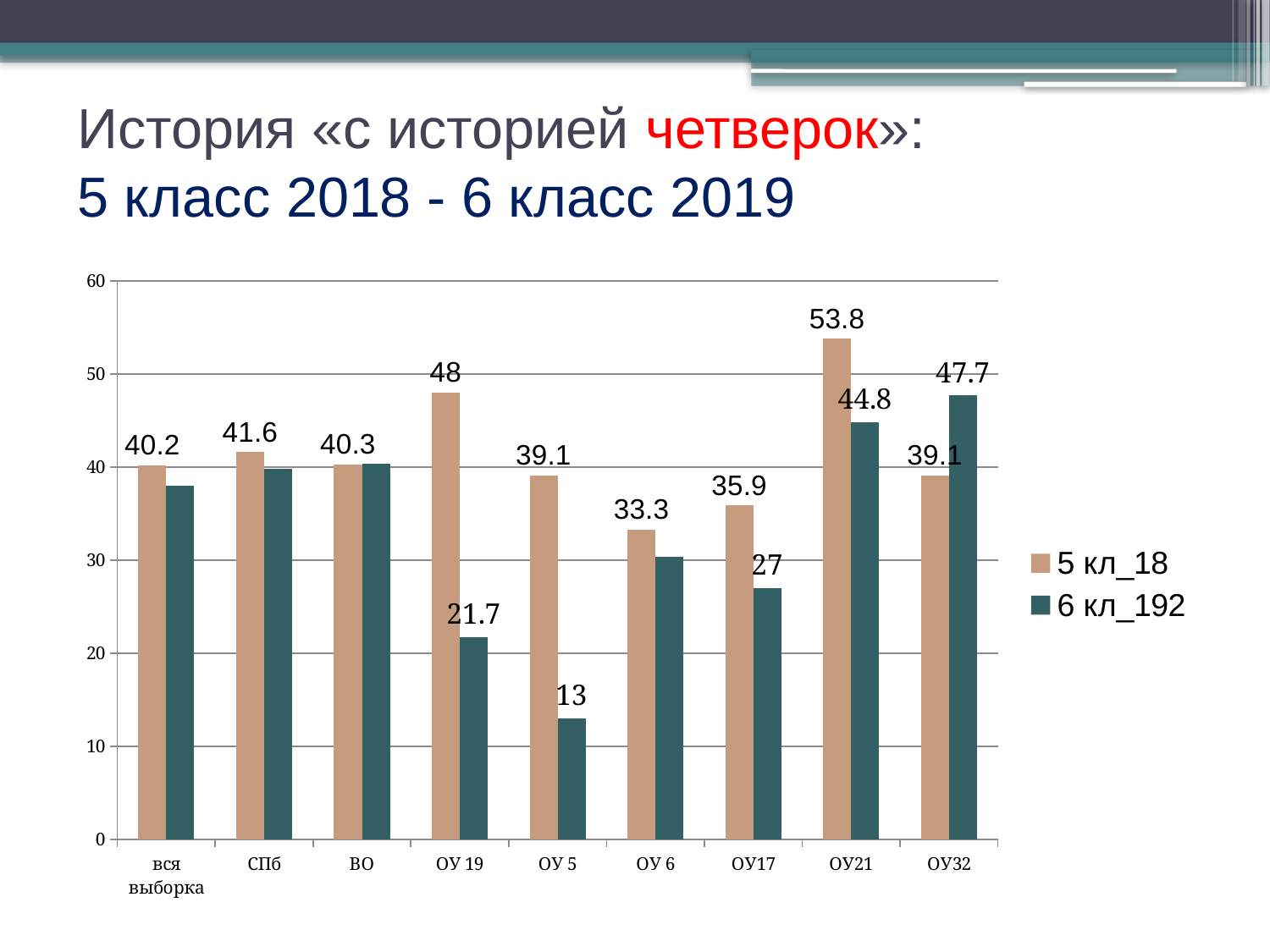
How many series does the legend list? 2 What kind of chart is shown on the slide? bar chart What is the value of the 6 кл_192 series for ОУ 5? 13 How many categories are shown on the x axis of the chart? 9 What are the two series names listed in the legend? 5 кл_18 and 6 кл_192 Which category has the lowest value in the 6 кл_192 series? ОУ 5 For ОУ32, which series has the larger value, 5 кл_18 or 6 кл_192? 6 кл_192 Is the value of the 6 кл_192 series for ОУ 6 greater or less than 40? less What is the value of the 6 кл_192 series for ОУ17? 27 What is the value of the 5 кл_18 series for ОУ21? 53.8 For ОУ 19, what is the difference between the 5 кл_18 value and the 6 кл_192 value? 26.3 Which category has the highest value in the 5 кл_18 series? ОУ21